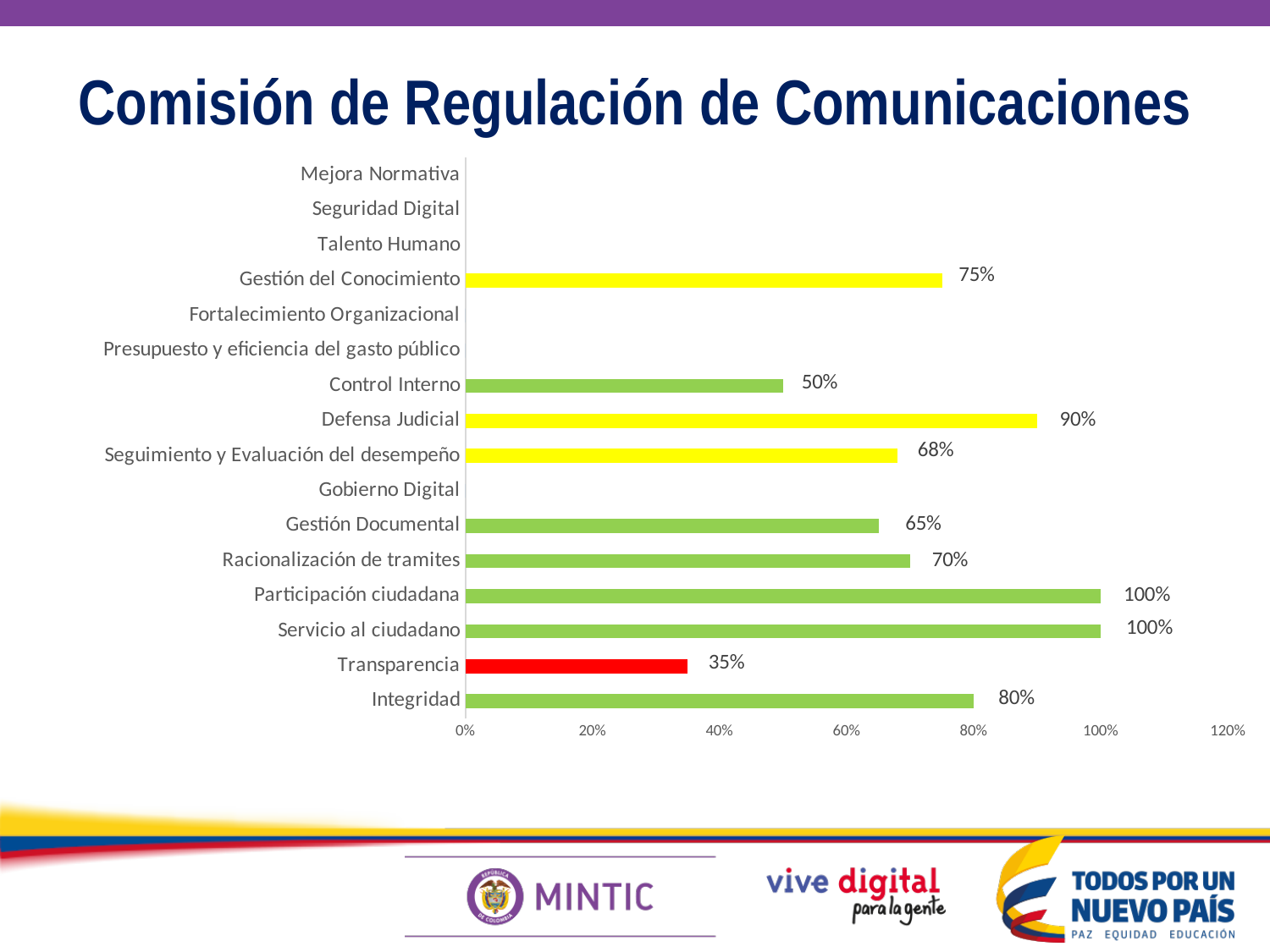
How many category labels are listed on the vertical axis? 16 What is the value for Integridad? 80% What is the difference between the values for Defensa Judicial and Control Interno? 40% Which category has the lowest value? Transparencia What kind of chart is shown on the slide? Bar chart What colour is the bar for Transparencia? Red What is the value for Transparencia? 35% What is the value for Seguimiento y Evaluación del desempeño? 68% Which categories share the highest value of 100%? Participación ciudadana and Servicio al ciudadano Which is larger, the value for Gestión Documental or the value for Racionalización de tramites? Racionalización de tramites How many categories have a bar plotted? 10 What is the value for Defensa Judicial? 90%